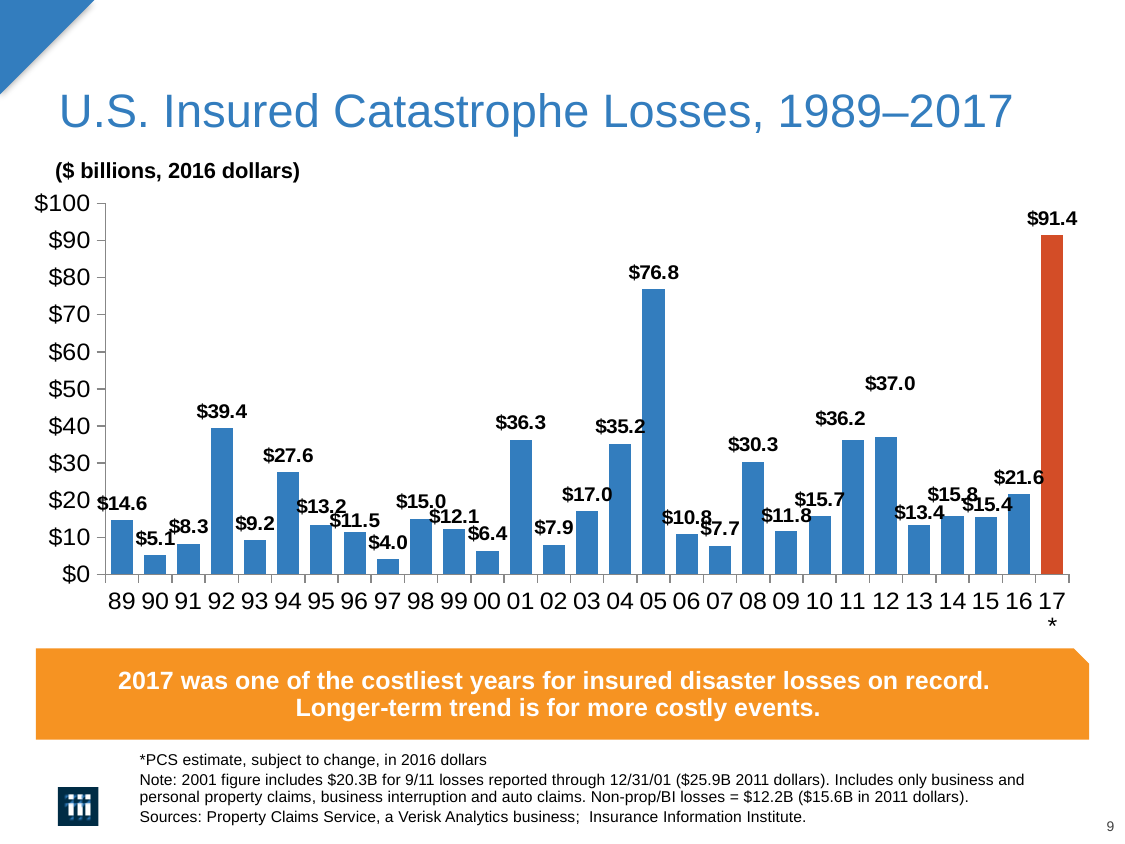
Which year has the highest insured catastrophe losses? 2017 How many years are plotted on the chart? 29 What kind of chart is shown on the slide? Bar chart What is the value for 2001? $36.3 What is the difference between the values for 2017 and 2005? $14.6 Which year has the lowest insured catastrophe losses? 1997 Which bar is shown in a different colour (orange) from the rest? 2017 Is the value for 2008 greater or less than $20? greater Which is larger, the value for 2012 or the value for 2011? 2012 What is the value for 2005? $76.8 What is the value for 1992? $39.4 What is the value for 2016? $21.6